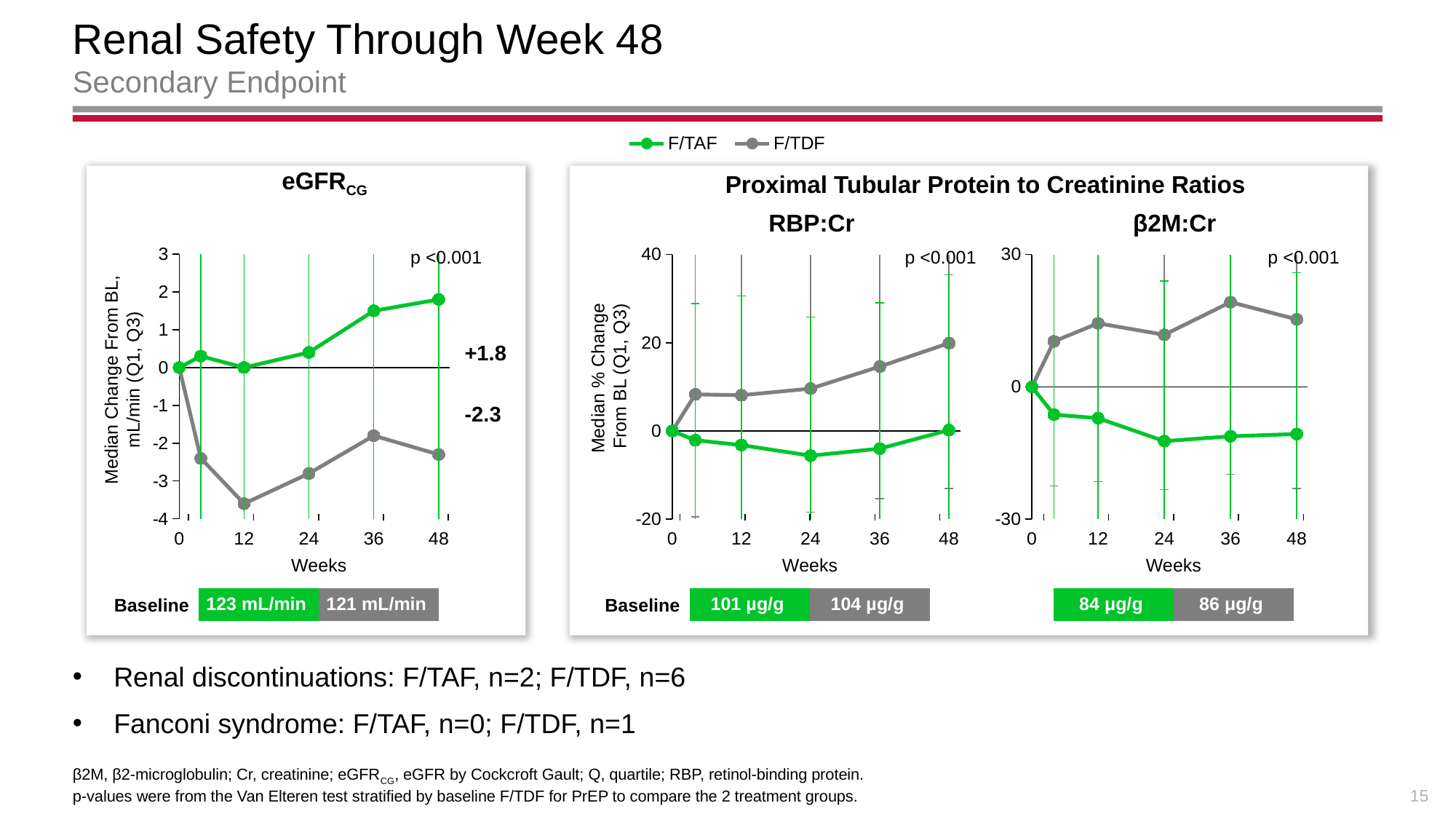
In the eGFR_CG chart, what is the baseline value shown for F/TAF? 123 mL/min In the eGFR_CG chart, what is the difference between the F/TAF and F/TDF values at week 48? 4.1 How many series does the legend at the top of the slide list? 2 In the eGFR_CG chart, at which week does the F/TDF series reach its lowest value? 12 In the eGFR_CG chart, is the F/TDF value at week 12 greater or less than -3? less In the RBP:Cr chart, which series has the higher value at week 48? F/TDF In the eGFR_CG chart, what is the median change from baseline for F/TDF at week 48? -2.3 In the RBP:Cr chart, does the F/TDF series rise or fall from week 0 to week 48? rises In the β2M:Cr chart, is the F/TAF value at week 48 greater or less than 0? less In the eGFR_CG chart, what is the median change from baseline for F/TAF at week 48? +1.8 In the β2M:Cr chart, what is the baseline value shown for F/TDF? 86 µg/g What kind of chart is the RBP:Cr chart? line chart